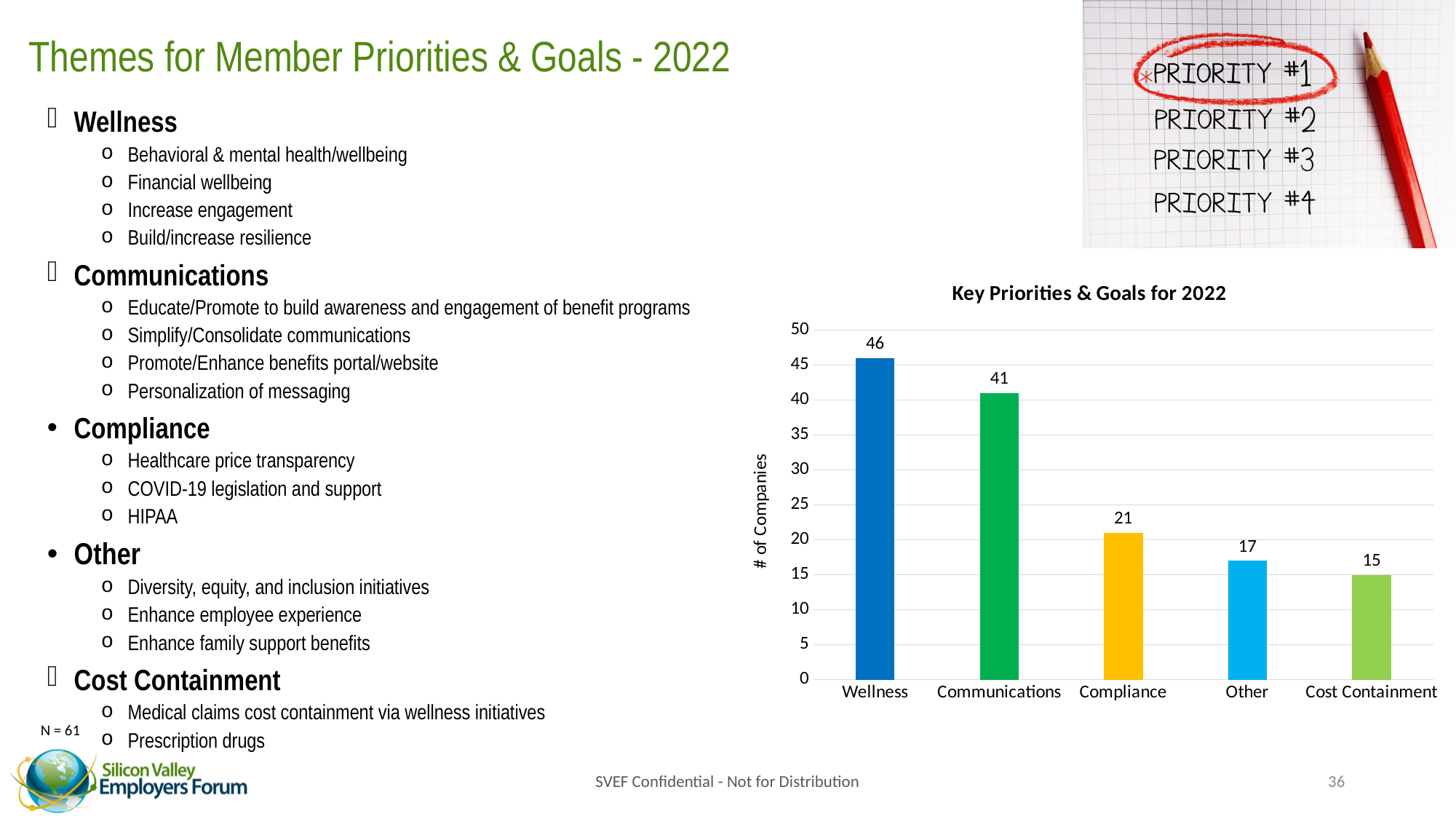
Which category has the lowest value? Cost Containment What is the difference between the values for Compliance and Other? 4 What is the value for Cost Containment? 15 What is the value for Wellness in the chart? 46 Which is larger, the value for Compliance or the value for Other? Compliance What kind of chart is shown on the slide? bar chart What is the title of the chart? Key Priorities & Goals for 2022 Which category has the highest value? Wellness What is the difference between the values for Wellness and Communications? 5 Is the value for Communications greater or less than 40? greater How many categories are shown in the chart? 5 How many companies listed Communications as a key priority? 41